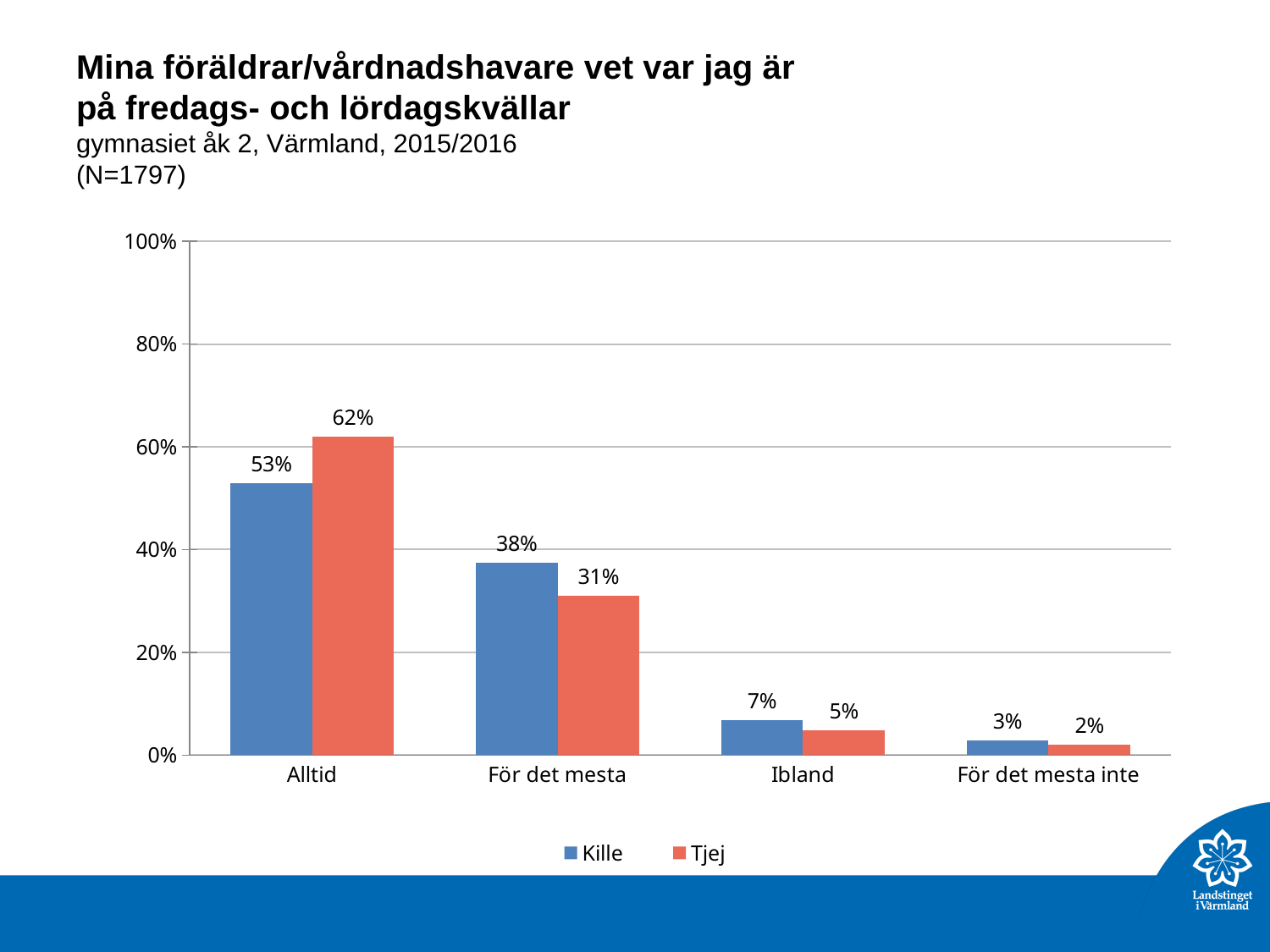
How many series does the legend list? 2 Is the value for Tjej in the Alltid category greater or less than 60%? greater What is the difference between the Tjej and Kille values in the Alltid category? 9% Which series is shown in red/orange in the legend? Tjej Which category has the lowest value for Kille? För det mesta inte What kind of chart is shown on the slide? Bar chart What is the value for Kille in the Alltid category? 53% How many categories are shown on the x axis? 4 What is the value for Tjej in the För det mesta category? 31% Which category has the highest value for Tjej? Alltid What is the value for Tjej in the Ibland category? 5% Which is larger in the För det mesta category, Kille or Tjej? Kille